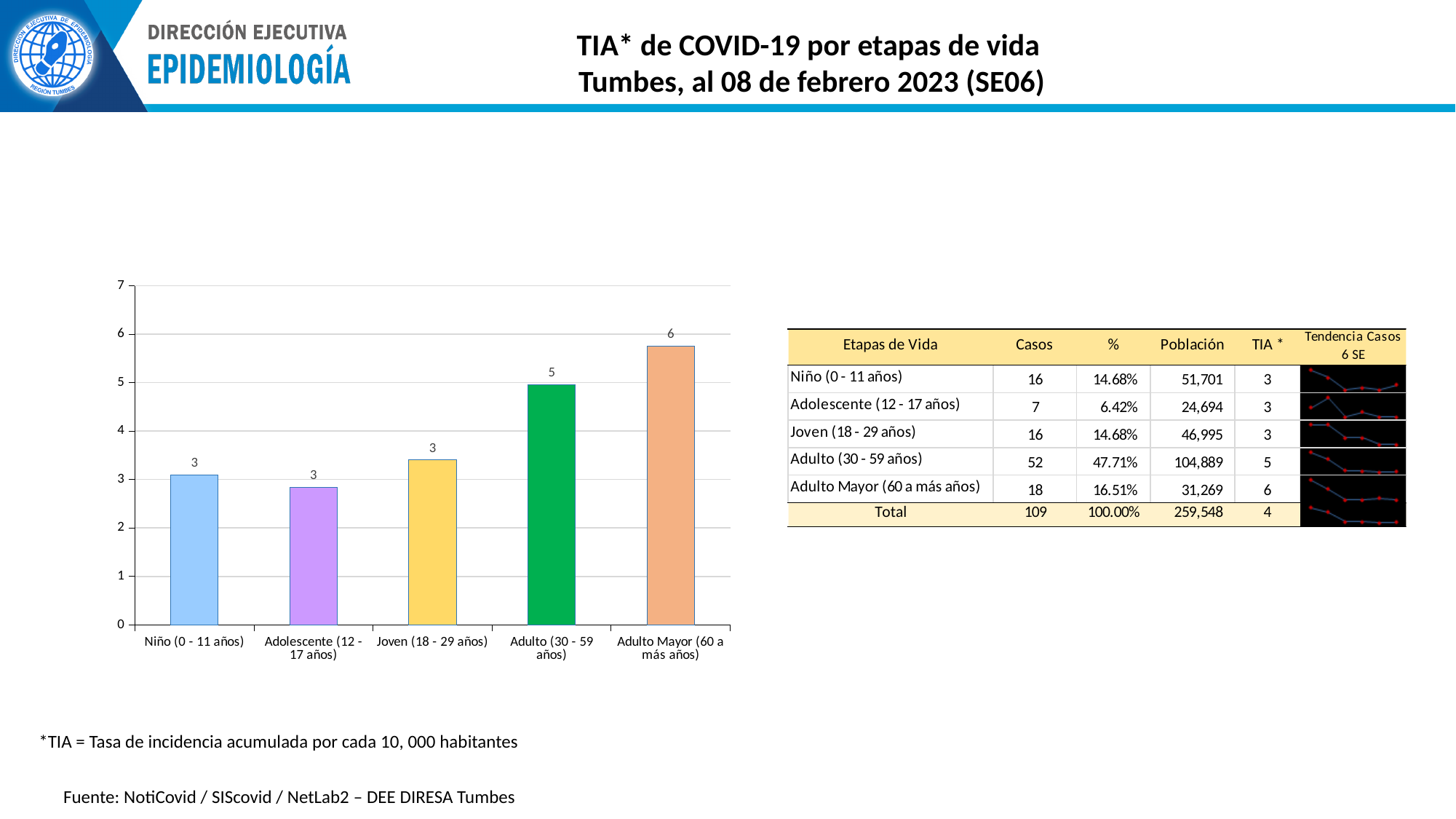
What is the data label shown for Adulto Mayor (60 a más años) in the bar chart? 6 Which bar is taller, Adulto Mayor (60 a más años) or Adulto (30 - 59 años)? Adulto Mayor (60 a más años) What is the data label shown for Adulto (30 - 59 años) in the bar chart? 5 What is the data label shown for Niño (0 - 11 años) in the bar chart? 3 What colour is the bar for Adulto (30 - 59 años)? green How many life-stage categories are plotted in the bar chart? 5 Which bar is taller, Adulto (30 - 59 años) or Joven (18 - 29 años)? Adulto (30 - 59 años) What kind of chart is shown on the slide? bar chart Which life stage has the highest bar in the chart? Adulto Mayor (60 a más años)